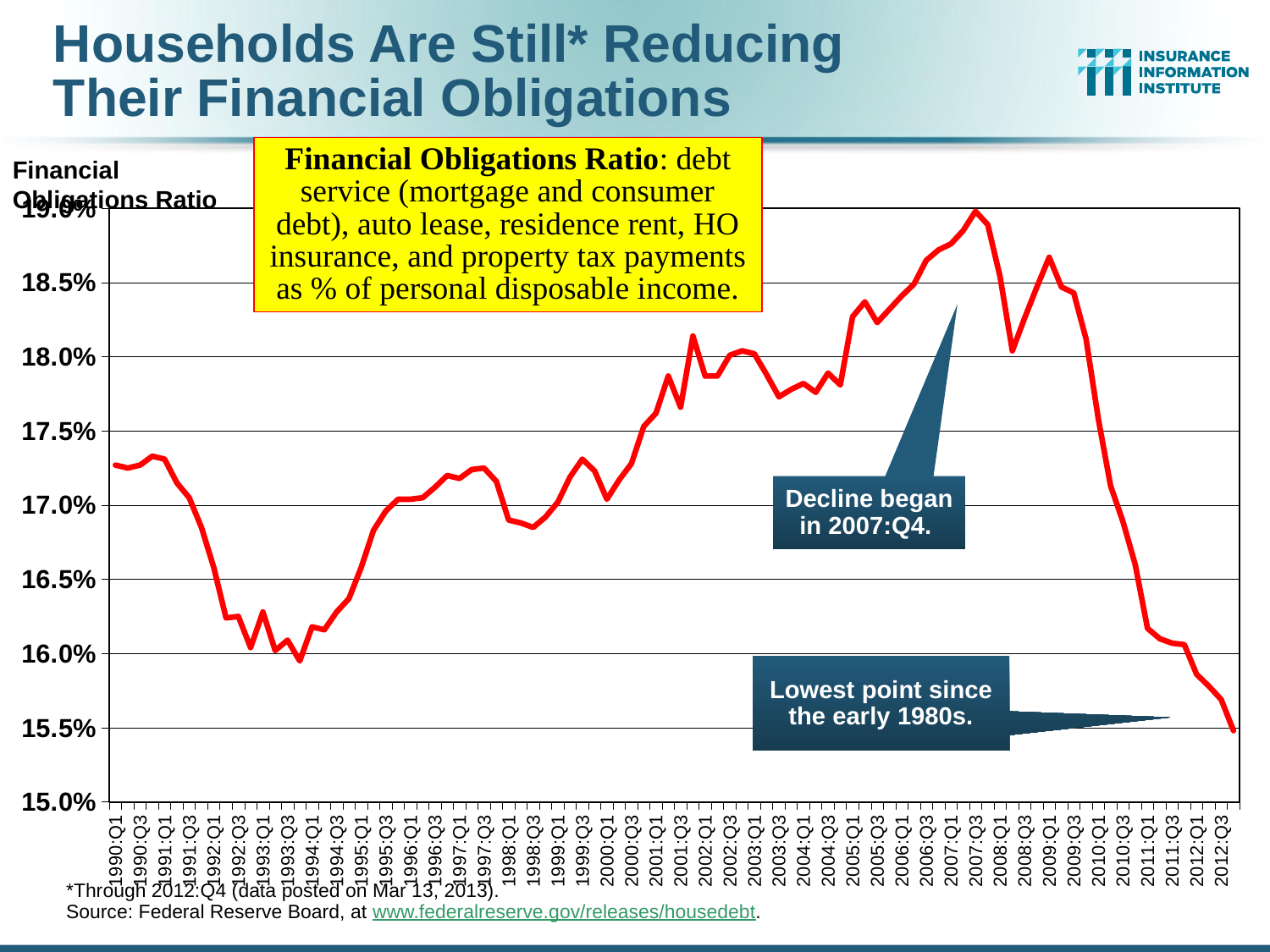
According to the chart annotation, the final point of the series is the lowest point since when? The early 1980s Is the Financial Obligations Ratio for 2007:Q3 greater or less than 18.5%? greater Is the Financial Obligations Ratio at the final point of the series (2012:Q4) greater or less than 16.0%? less Which is larger, the Financial Obligations Ratio in 1993:Q3 or at the final point of the series (2012:Q4)? 1993:Q3 Is the Financial Obligations Ratio for 1990:Q1 greater or less than 17.0%? greater How many data series are plotted on the chart? 1 What kind of chart is shown on the slide? Line chart Does the Financial Obligations Ratio rise or fall from 2007:Q4 to the end of the series? fall According to the chart annotation, in which quarter did the decline in the Financial Obligations Ratio begin? 2007:Q4 Which is larger, the Financial Obligations Ratio in 2007:Q3 or in 1990:Q1? 2007:Q3